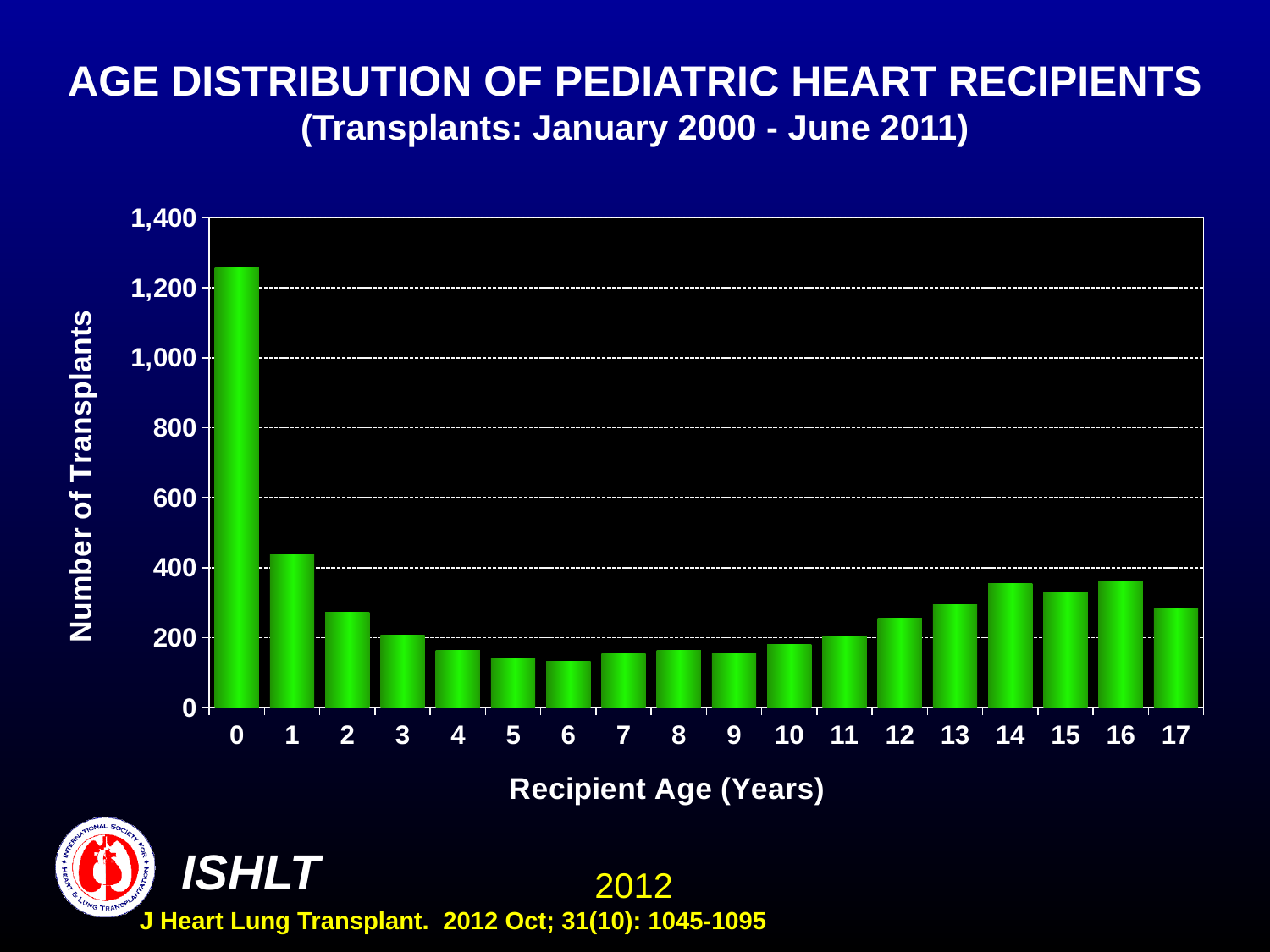
Is the number of transplants for recipient age 0 greater or less than 1,200? greater Is the number of transplants for recipient age 6 greater or less than 200? less How many recipient age categories are shown on the x axis? 18 Which has more transplants, recipient age 1 or recipient age 2? 1 Which recipient age has the highest number of transplants? 0 Do the number of transplants generally rise or fall from recipient age 0 to age 6? fall Is the number of transplants for recipient age 14 greater or less than 400? less What is the label of the x axis? Recipient Age (Years) What kind of chart is shown on the slide? bar chart Which has more transplants, recipient age 13 or recipient age 14? 14